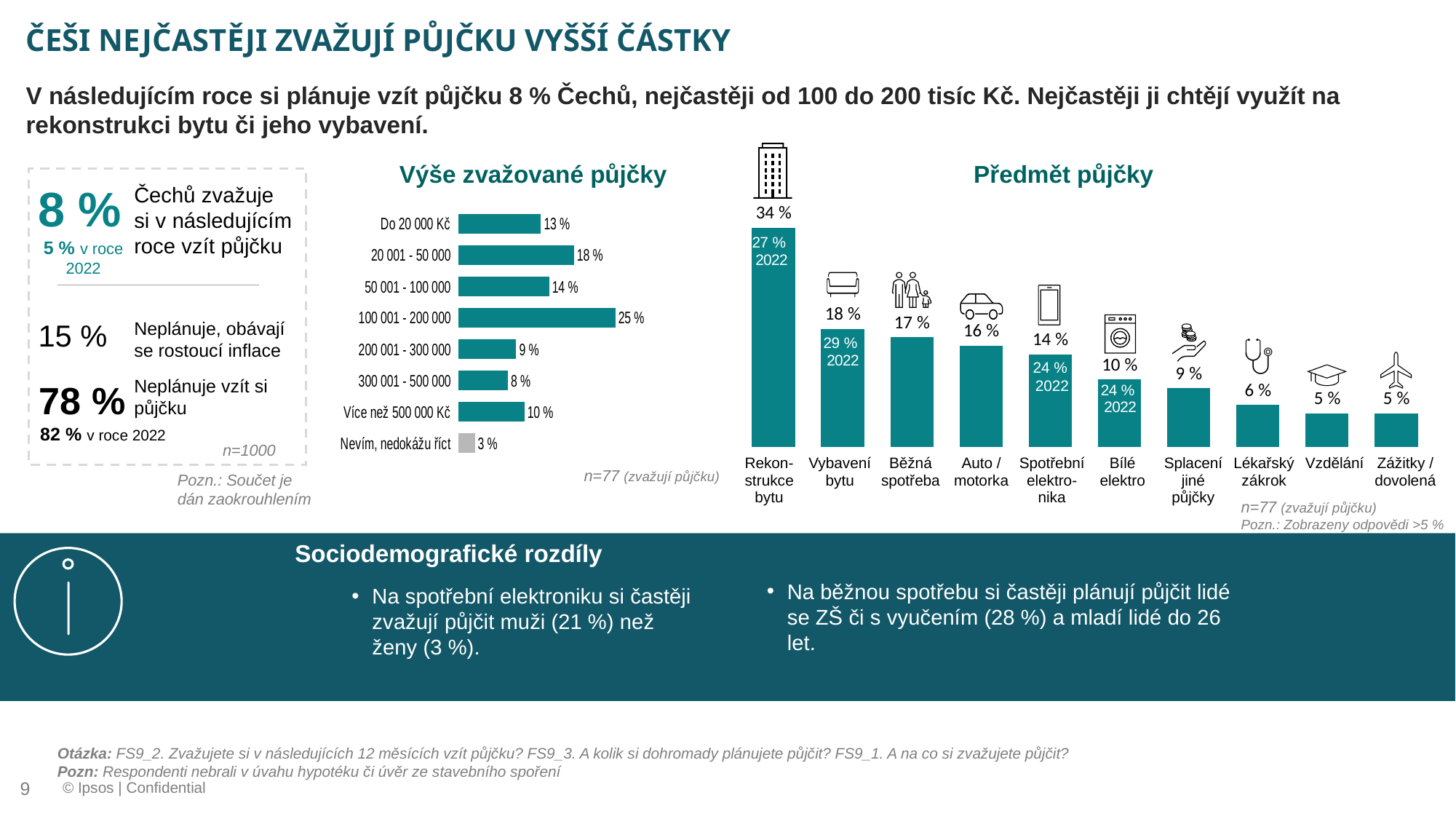
What type of chart is 'Výše zvažované půjčky'? Bar chart In the 'Předmět půjčky' chart, which category has the highest value? Rekonstrukce bytu In the 'Předmět půjčky' chart, what is the value for 'Auto / motorka'? 16 % In the 'Předmět půjčky' chart, how many categories are shown? 10 In the 'Výše zvažované půjčky' chart, how many categories are shown? 8 In the 'Předmět půjčky' chart, what was the 2022 value for 'Vybavení bytu'? 29 % In the 'Předmět půjčky' chart, what is the difference between 'Rekonstrukce bytu' and 'Vybavení bytu'? 16 % In the 'Výše zvažované půjčky' chart, which category has the lowest value? Nevím, nedokážu říct In the 'Předmět půjčky' chart, do the values rise or fall from left to right? Fall In the 'Výše zvažované půjčky' chart, which is larger: 'Do 20 000 Kč' or 'Více než 500 000 Kč'? Do 20 000 Kč In the 'Výše zvažované půjčky' chart, what is the value for '100 001 - 200 000'? 25 % In the 'Výše zvažované půjčky' chart, what is the difference between '20 001 - 50 000' and '50 001 - 100 000'? 4 %